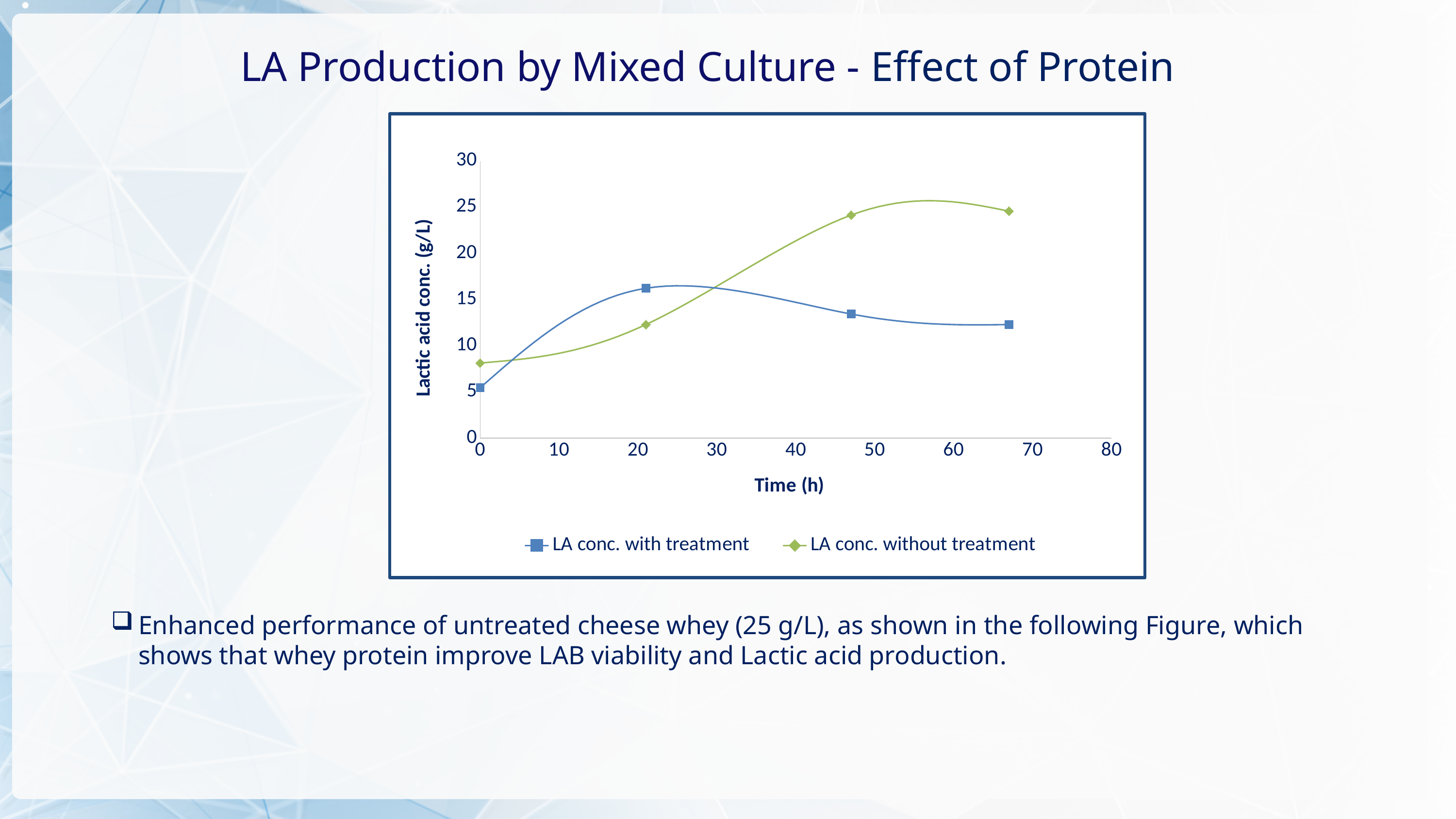
At the last data point (around 67 h), which series has the higher lactic acid concentration? LA conc. without treatment How many series does the legend list? 2 At the second data point (around 20 h), which series has the higher lactic acid concentration? LA conc. with treatment Is the value for 'LA conc. without treatment' at its third data point (around 47 h) greater or less than 20 g/L? greater What kind of chart is shown on the slide? line chart How many data points are plotted for the 'LA conc. with treatment' series? 4 Is the value for 'LA conc. without treatment' at time 0 h greater or less than 10 g/L? less Does the 'LA conc. without treatment' series generally rise or fall from 0 h to around 47 h? rise At time 0 h, which series has the higher lactic acid concentration? LA conc. without treatment Is the value for 'LA conc. with treatment' at its last data point (around 67 h) greater or less than 15 g/L? less Which series reaches the highest lactic acid concentration on the chart? LA conc. without treatment What is the label of the y axis? Lactic acid conc. (g/L)